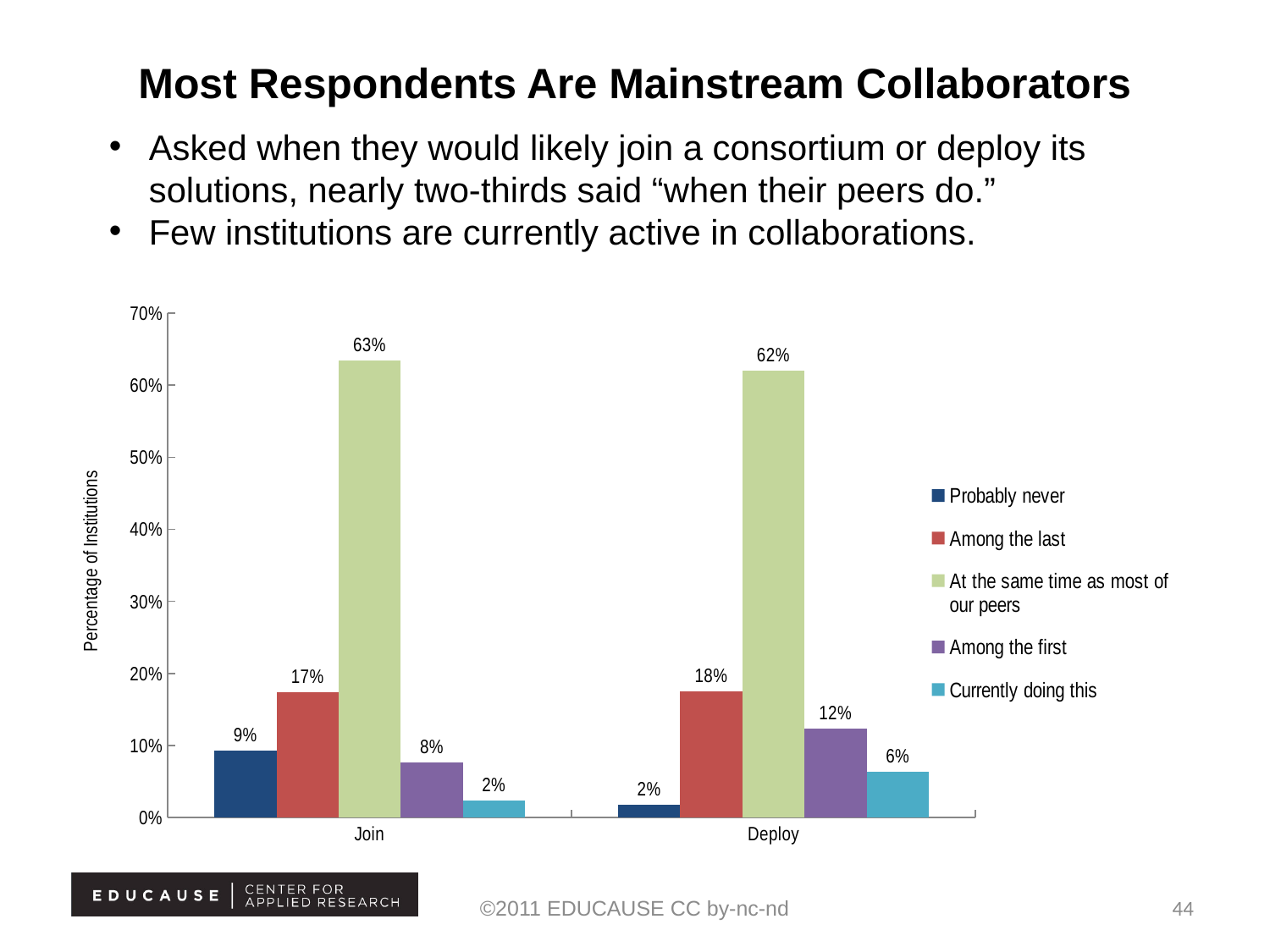
What is the value for 'Among the last' in the Deploy category? 18% What percentage of institutions said they would join a consortium at the same time as most of their peers? 63% What is the label of the y axis? Percentage of Institutions What percentage of institutions are currently deploying consortium solutions ('Currently doing this' for Deploy)? 6% How many series does the legend list? 5 How many categories are shown on the x axis? 2 What is the difference between 'Among the first' for Deploy and 'Among the first' for Join? 4% Which response has the highest value in the Deploy category? At the same time as most of our peers What is the value for 'Probably never' in the Join category? 9% Which response has the lowest value in the Join category? Currently doing this What kind of chart is shown on the slide? Bar chart Which is larger: 'Probably never' for Join or 'Probably never' for Deploy? Probably never for Join